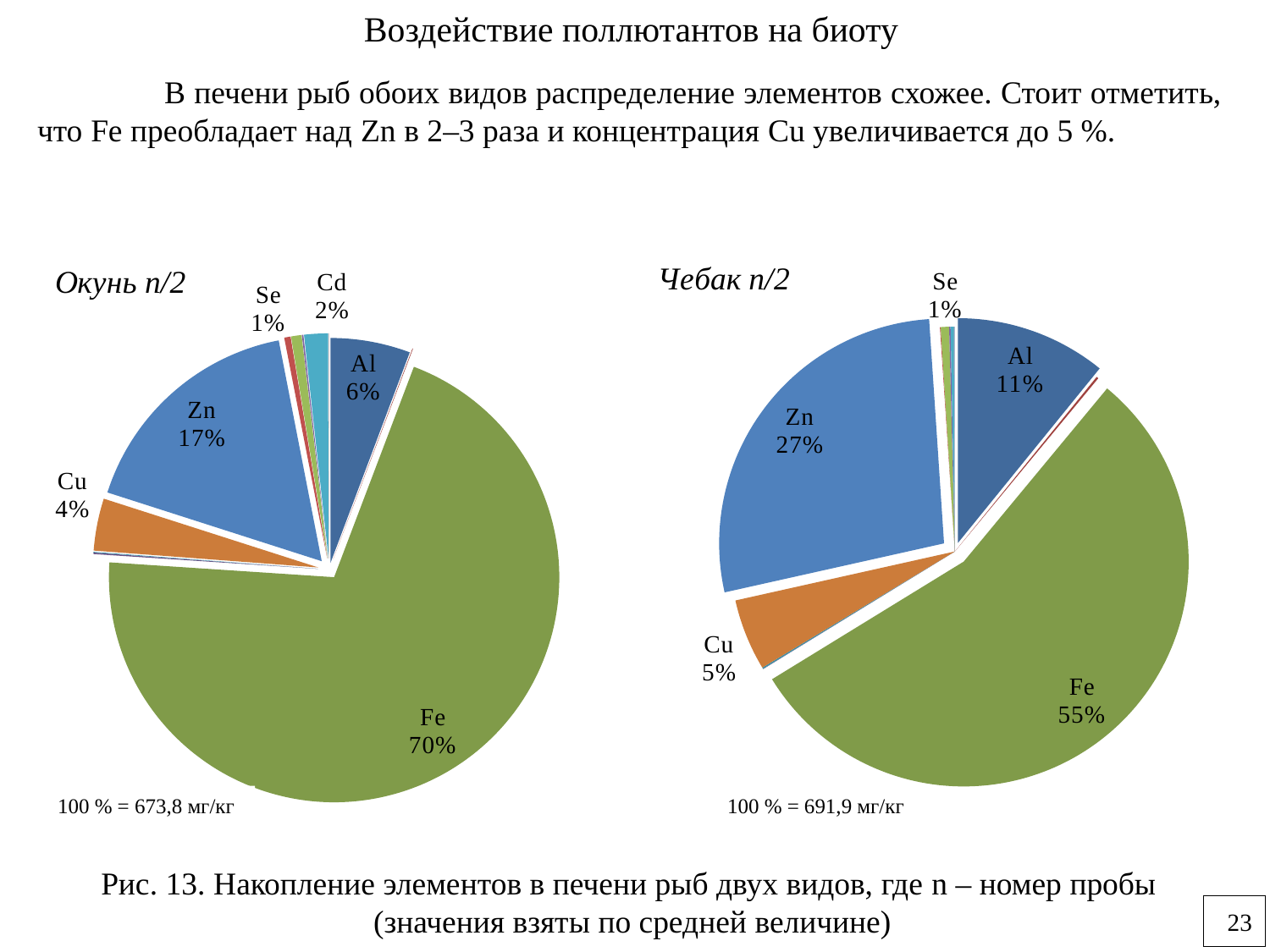
In the left pie chart (Окунь n/2), how much larger is the share of Fe than the share of Zn? 53% Which chart shows a larger share for Zn, the left (Окунь n/2) or the right (Чебак n/2)? Right (Чебак n/2) In the right pie chart (Чебак n/2), what is the share of Al? 11% In the right pie chart (Чебак n/2), which element has the largest share? Fe According to the note under the left pie chart (Окунь n/2), what does 100 % correspond to? 673,8 мг/кг In the left pie chart (Окунь n/2), what is the share of Cd? 2% In the right pie chart (Чебак n/2), what share does Zn have? 27% What type of chart is used on this slide? Pie chart In the left pie chart (Окунь n/2), what share does Fe have? 70% In the right pie chart (Чебак n/2), what is the difference between the shares of Fe and Zn? 28% In the left pie chart (Окунь n/2), what is the share of Cu? 4% In the left pie chart (Окунь n/2), which element has the largest share? Fe